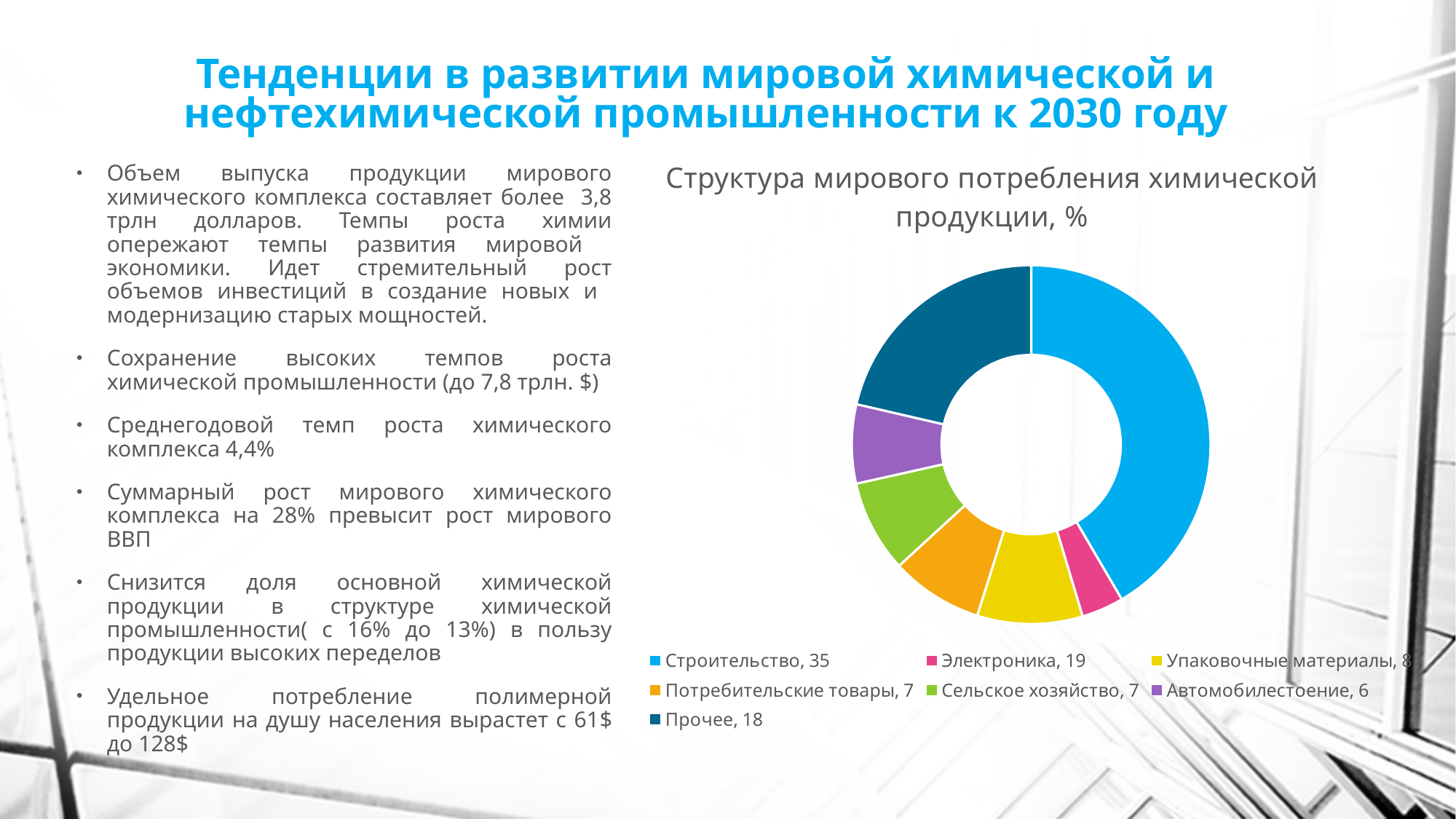
What is the value for Строительство? 35 What is the difference between the values for Строительство and Прочее? 17 How many categories does the chart show? 7 Which is larger, Строительство or Прочее? Строительство What is the value for Прочее? 18 What colour is the Строительство slice? Light blue What is the value for Упаковочные материалы? 8 What is the title of the chart? Структура мирового потребления химической продукции, % What is the value for Автомобилестоение? 6 What kind of chart is shown on the slide? Doughnut (pie) chart Which category has the highest value? Строительство What is the value for Сельское хозяйство? 7